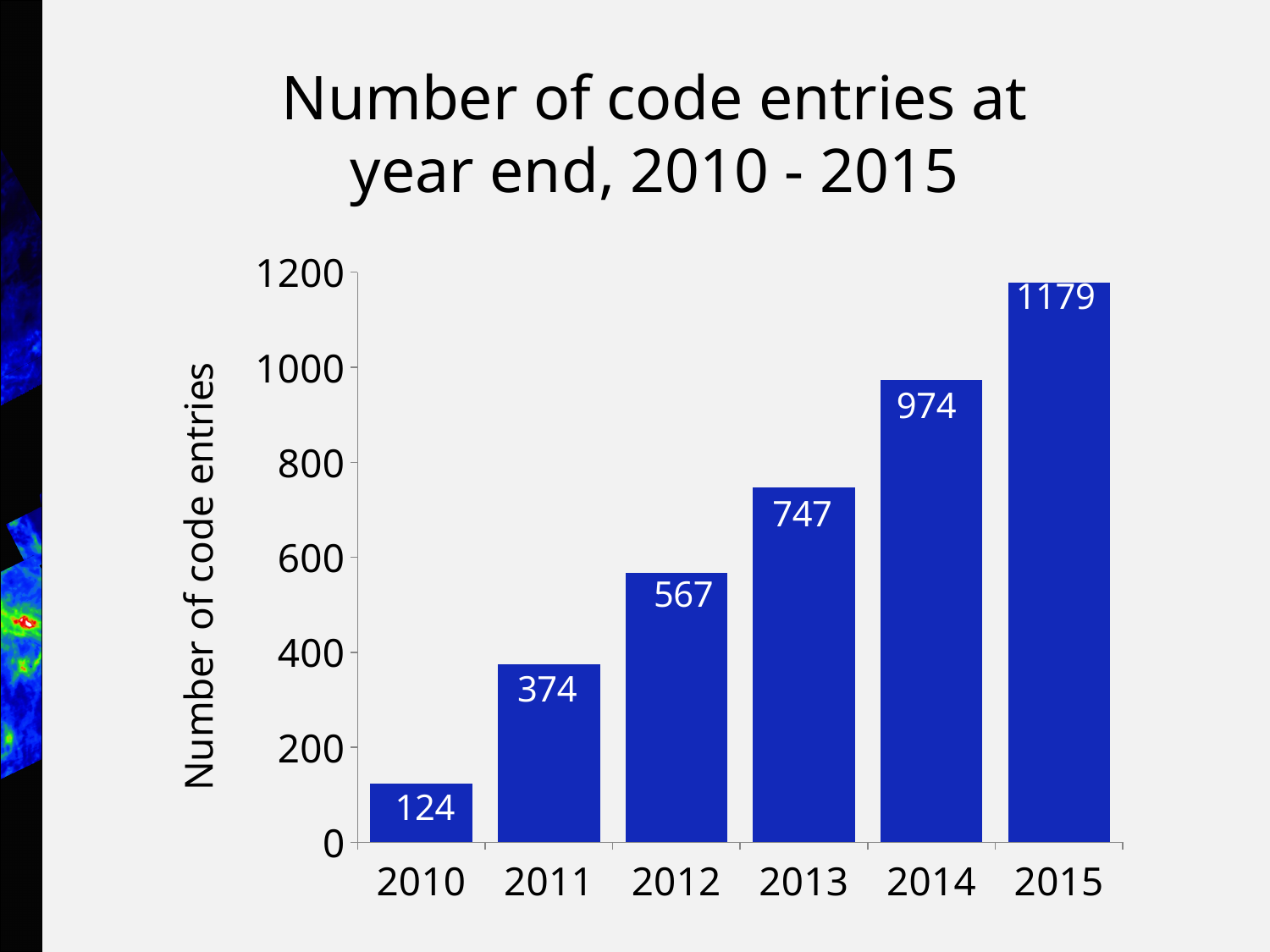
What is the difference in code entries between 2013 and 2011? 373 What is the number of code entries at year end 2014? 974 What is the difference in code entries between 2015 and 2014? 205 Do the number of code entries rise or fall from 2010 to 2015? rise Which year has the lowest number of code entries? 2010 Which year has more code entries, 2012 or 2013? 2013 What is the number of code entries at year end 2010? 124 What is the number of code entries at year end 2012? 567 Is the value for 2011 greater or less than 400? less What kind of chart is shown on the slide? bar chart Which year has the highest number of code entries? 2015 How many years are shown on the x axis? 6